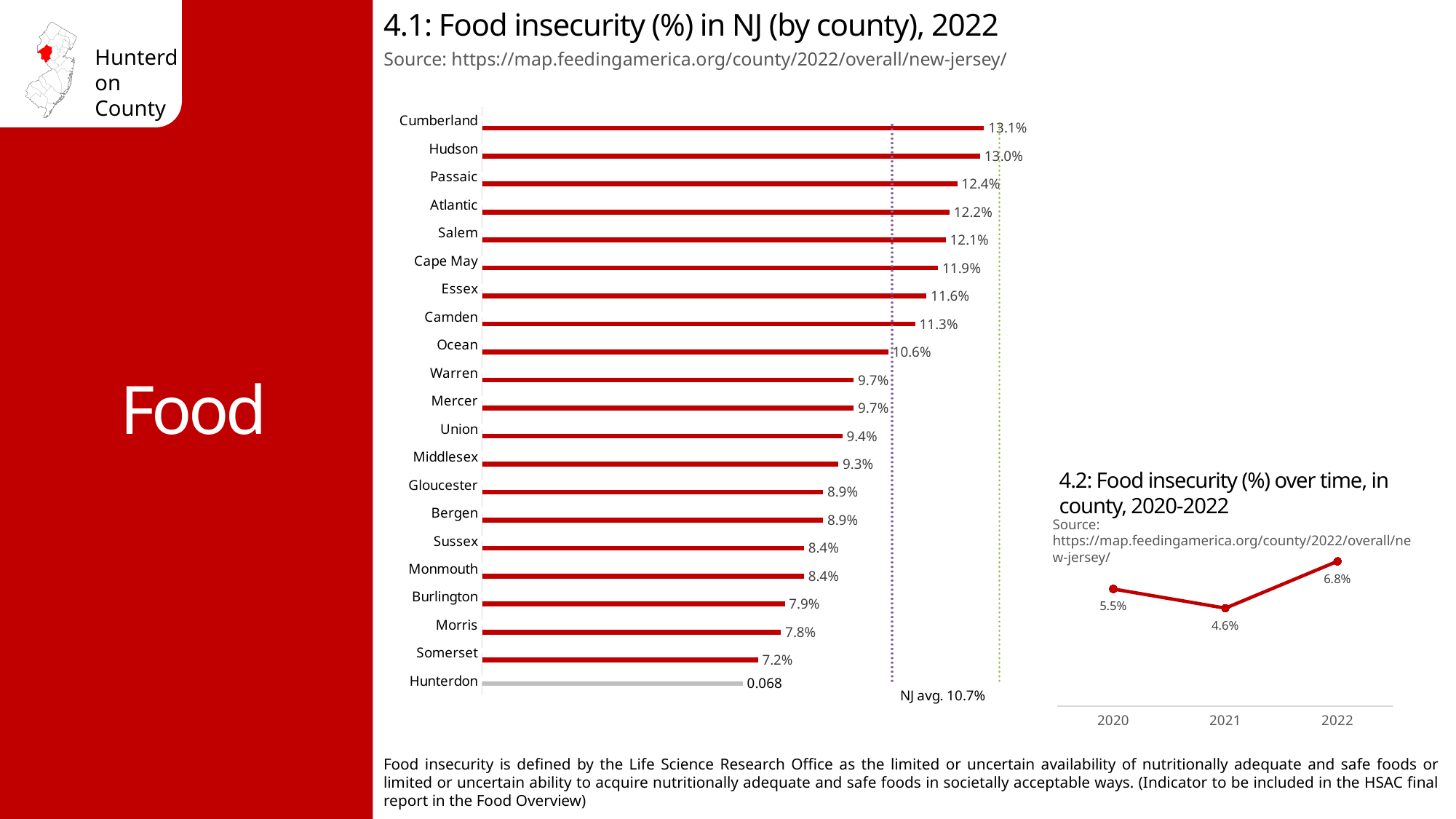
In chart 4.1 (Food insecurity in NJ by county, 2022), how many counties are plotted? 21 In chart 4.2 (Food insecurity over time in county, 2020-2022), what is the value for 2021? 4.6% In chart 4.1 (Food insecurity in NJ by county, 2022), which is larger, Ocean or Union? Ocean In chart 4.1 (Food insecurity in NJ by county, 2022), which county has the lowest value? Hunterdon In chart 4.1 (Food insecurity in NJ by county, 2022), what NJ average value is marked by the dotted line? 10.7% In chart 4.1 (Food insecurity in NJ by county, 2022), what is the data label shown for Hunterdon? 0.068 In chart 4.2 (Food insecurity over time in county, 2020-2022), what is the difference between 2022 and 2021? 2.2 percentage points In chart 4.1 (Food insecurity in NJ by county, 2022), which county has the highest value? Cumberland In chart 4.1 (Food insecurity in NJ by county, 2022), what is the value for Essex? 11.6% In chart 4.1 (Food insecurity in NJ by county, 2022), what is the difference between Cumberland and Somerset? 5.9 percentage points In chart 4.1 (Food insecurity in NJ by county, 2022), what is the value for Somerset? 7.2% What kind of chart is chart 4.1 (Food insecurity in NJ by county, 2022)? Bar chart